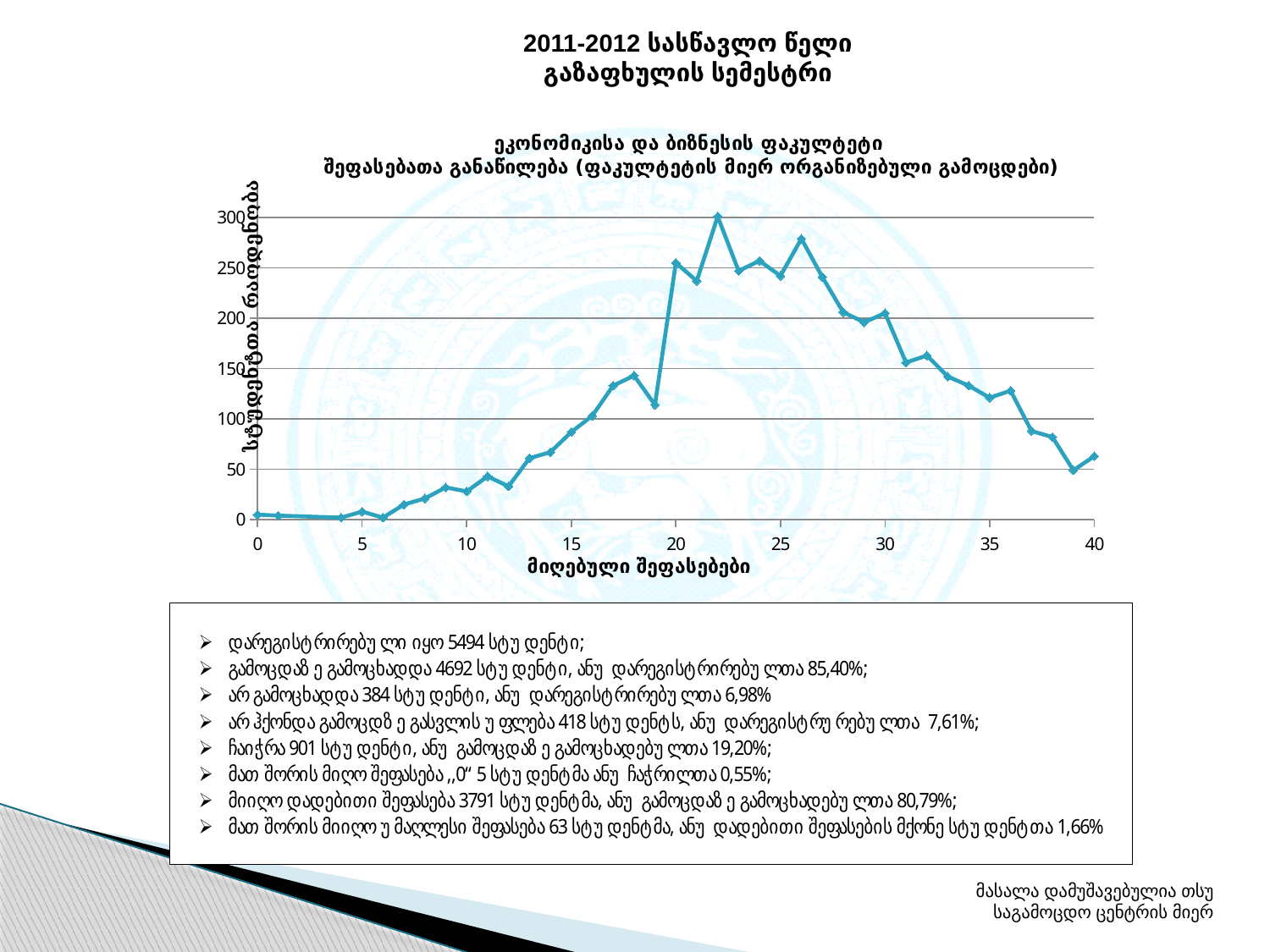
What is the label of the y axis? სტუდენტთა რაოდენობა What is the label of the x axis? მიღებული შეფასებები Which has the larger value, score 20 or score 10? score 20 Is the value at score 10 greater or less than 50? less Is the value at score 40 greater or less than 50? greater Is the value at score 22 greater or less than 250? greater At which score on the x axis does the line reach its highest value? 22 Which has the larger value, score 26 or score 30? score 26 What kind of chart is shown on the slide? line chart Do the values generally rise or fall along the x axis between scores 26 and 40? fall